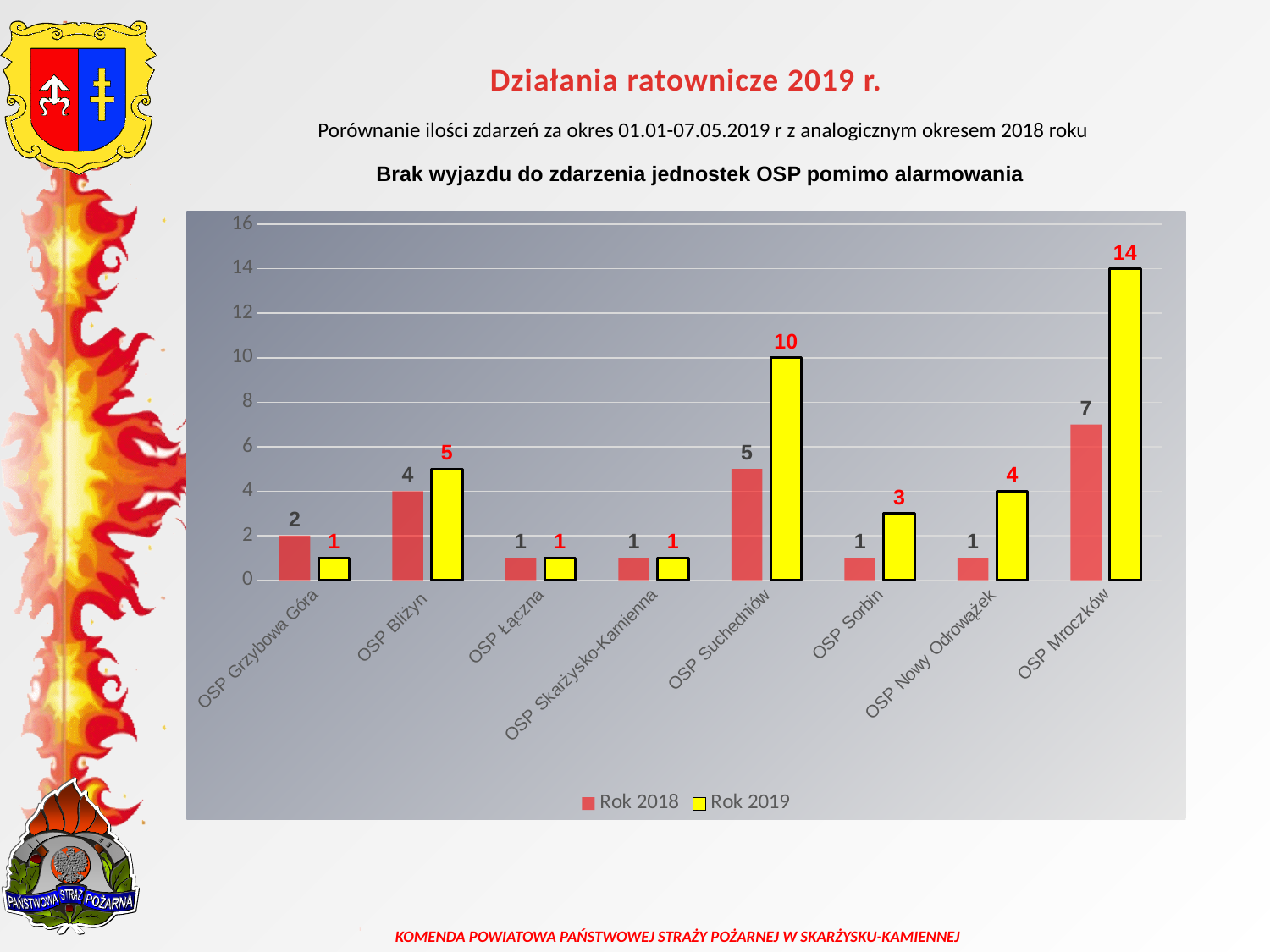
What is the difference between the Rok 2019 and Rok 2018 values for OSP Suchedniów? 5 What is the value for OSP Mroczków in the Rok 2019 series? 14 What is the value for OSP Suchedniów in the Rok 2018 series? 5 Which is larger for OSP Grzybowa Góra: the Rok 2018 value or the Rok 2019 value? Rok 2018 What is the difference between the Rok 2019 and Rok 2018 values for OSP Mroczków? 7 What kind of chart is shown on the slide? Bar chart Which category has the highest value in the Rok 2019 series? OSP Mroczków How many categories are shown on the x axis? 8 What colour are the Rok 2019 bars? Yellow Which category has the lowest value in the Rok 2018 series among OSP Grzybowa Góra, OSP Bliżyn and OSP Suchedniów? OSP Grzybowa Góra How many series does the legend list? 2 What is the value for OSP Bliżyn in the Rok 2019 series? 5